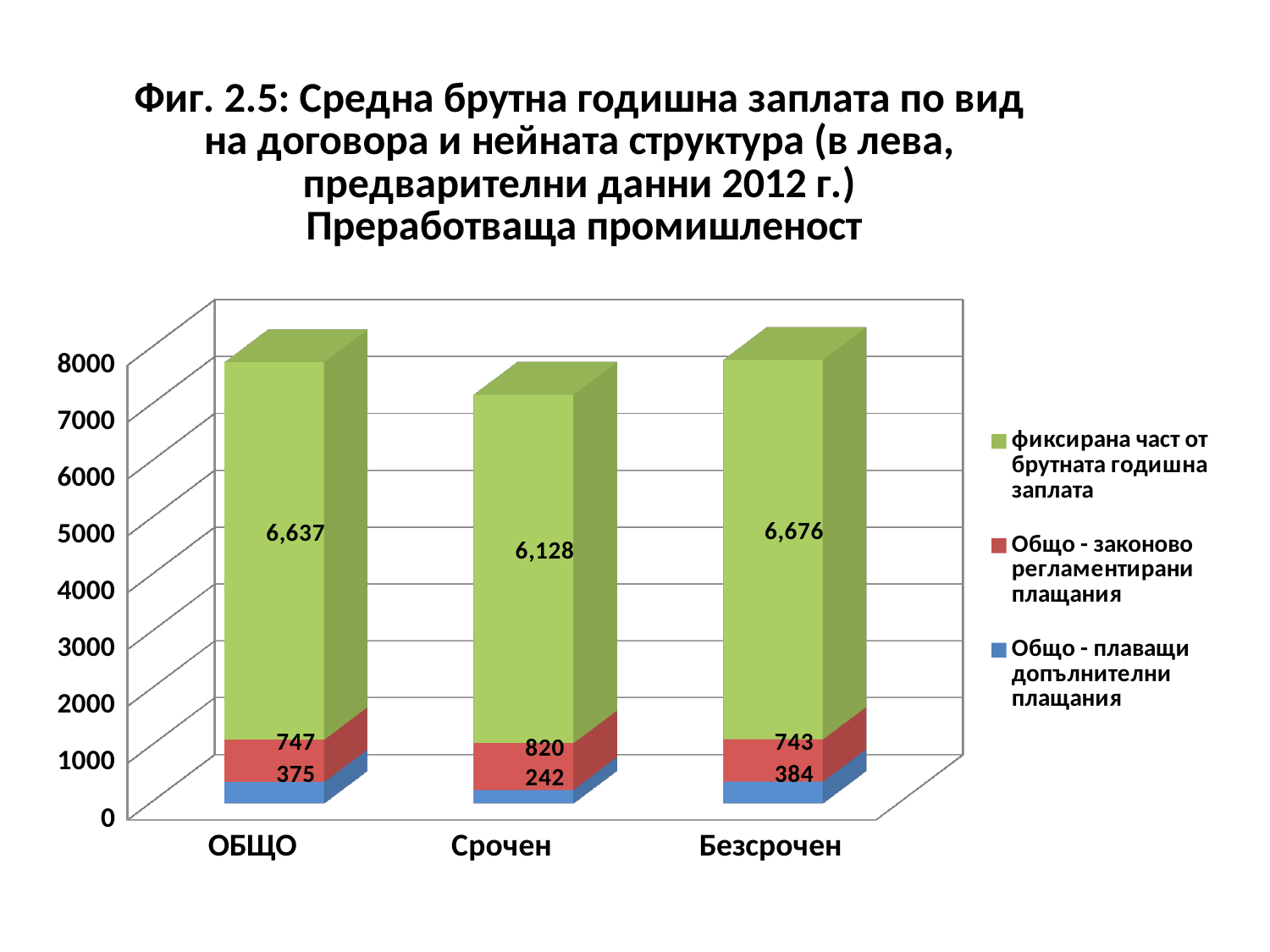
How many categories are shown on the x axis? 3 What is the value of Общо - плаващи допълнителни плащания for Безсрочен? 384 What is the value of Общо - законово регламентирани плащания for ОБЩО? 747 Which category has the lowest value for Общо - плаващи допълнителни плащания? Срочен How many series does the legend list? 3 What is the total of the stacked bar for Безсрочен? 7,803 What is the value of the fixed part of gross annual salary (фиксирана част от брутната годишна заплата) for Срочен? 6,128 Which contract type has the highest value for Общо - законово регламентирани плащания? Срочен What is the difference between the fixed part of gross annual salary for Безсрочен and for Срочен? 548 Which is larger: the fixed part of gross annual salary for ОБЩО or for Безсрочен? Безсрочен What kind of chart is shown on the slide? Stacked bar chart What is the total of the stacked bar for Срочен? 7,190